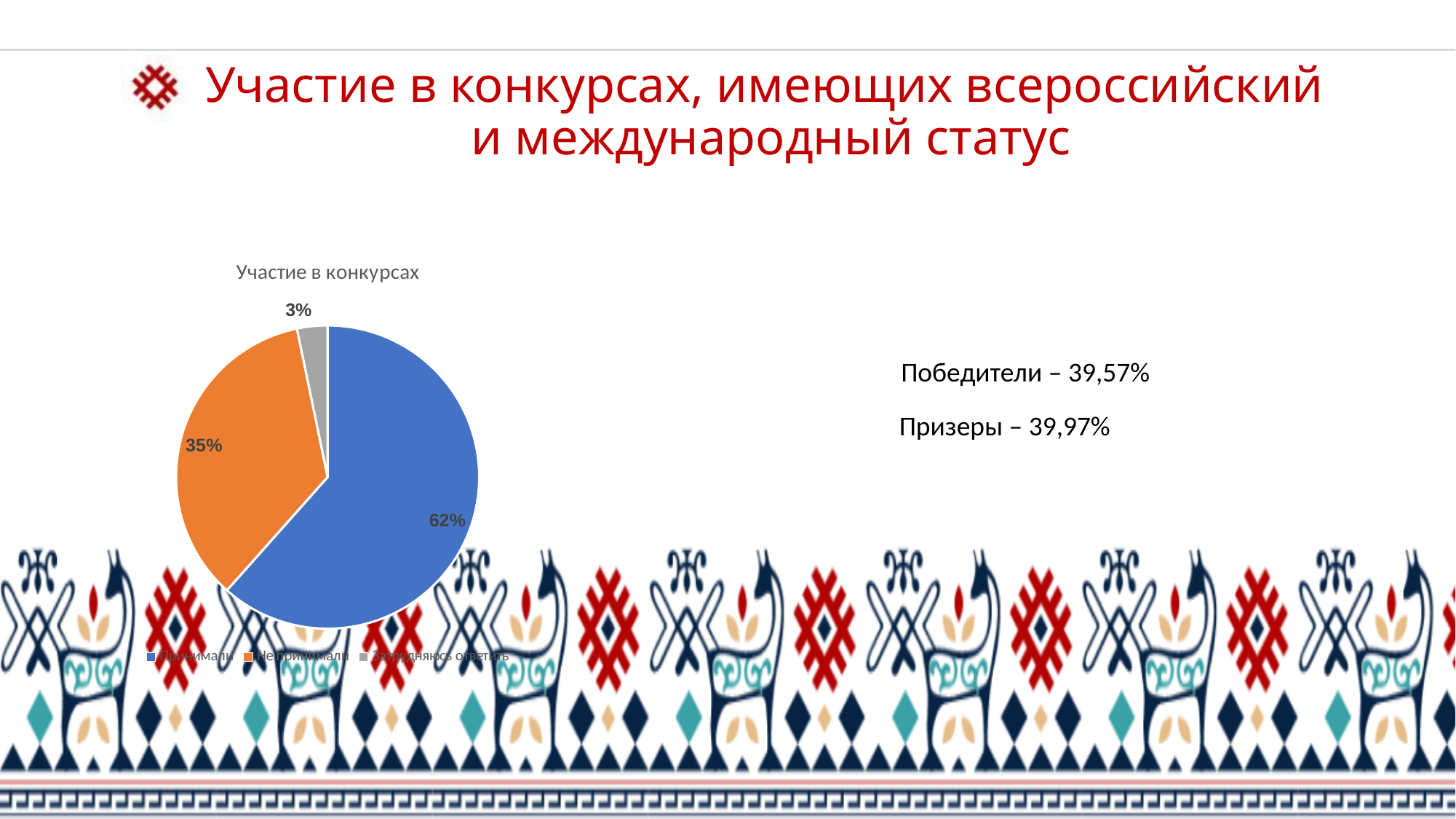
Which is larger in the pie chart, the blue slice or the orange slice? The blue slice How many entries does the legend of the pie chart list? 3 What kind of chart is shown on the slide? Pie chart Which slice of the pie chart is the smallest? The grey slice (3%) Is the value of the blue slice greater or less than 50%? greater What percentage is shown for the orange slice of the pie chart? 35% What is the difference between the blue slice and the orange slice of the pie chart? 27 percentage points How many slices does the pie chart have? 3 What is the title of the chart on the slide? Участие в конкурсах What percentage is shown for the blue slice of the pie chart? 62% What percentage is shown for the grey slice of the pie chart? 3% Which slice of the pie chart is the largest? The blue slice (62%)